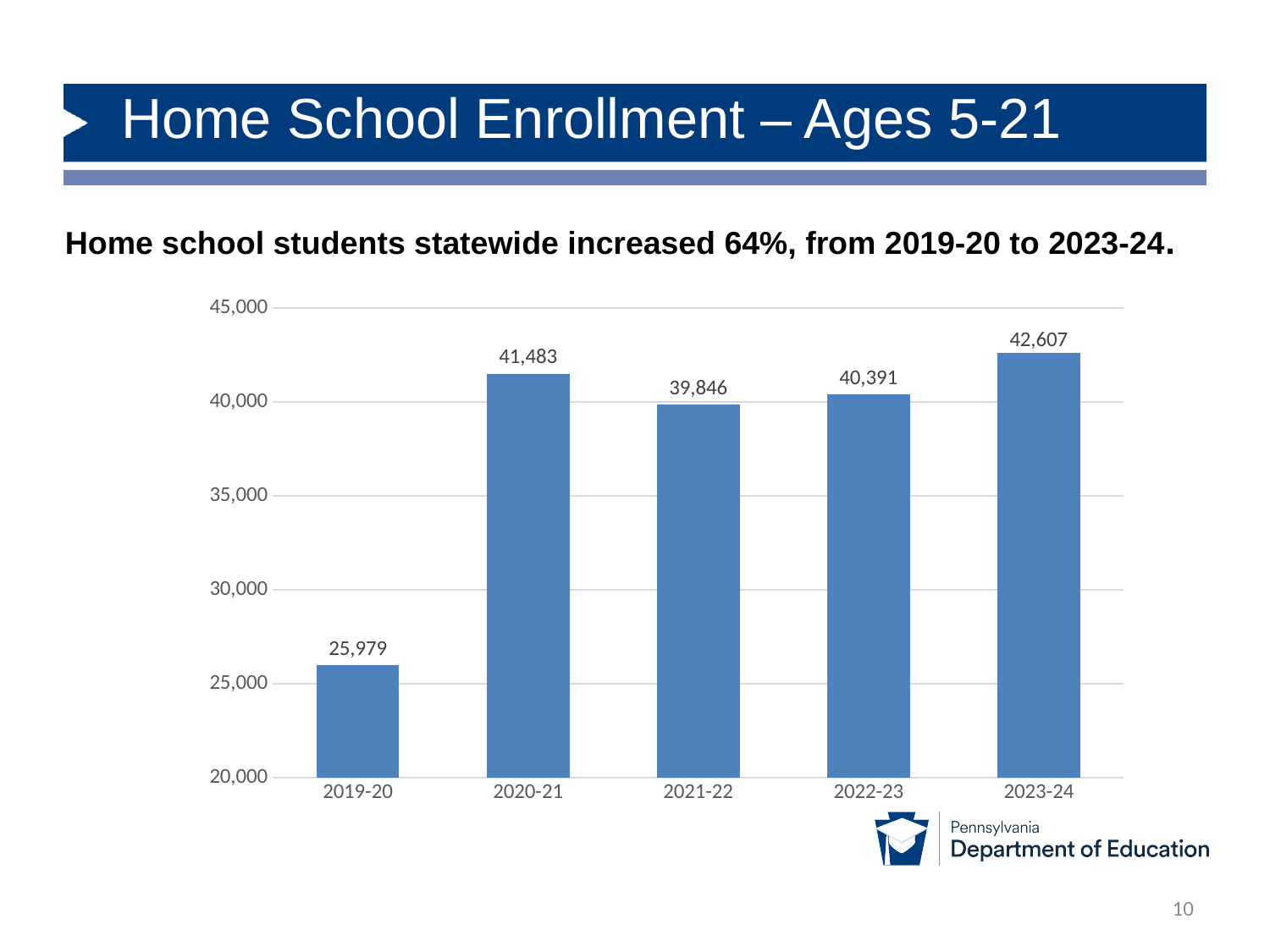
Which school year had the lowest home school enrollment? 2019-20 What was the home school enrollment in 2021-22? 39,846 What was the home school enrollment in 2023-24? 42,607 By what percentage did home school students statewide increase from 2019-20 to 2023-24, according to the slide? 64% Which year had higher home school enrollment, 2020-21 or 2022-23? 2020-21 What is the difference in home school enrollment between 2020-21 and 2021-22? 1,637 What was the home school enrollment in 2019-20? 25,979 How many school years are shown in the chart? 5 Is the home school enrollment for 2021-22 greater or less than 40,000? less What kind of chart is shown on the slide? bar chart What is the difference in home school enrollment between 2023-24 and 2019-20? 16,628 Which school year had the highest home school enrollment? 2023-24